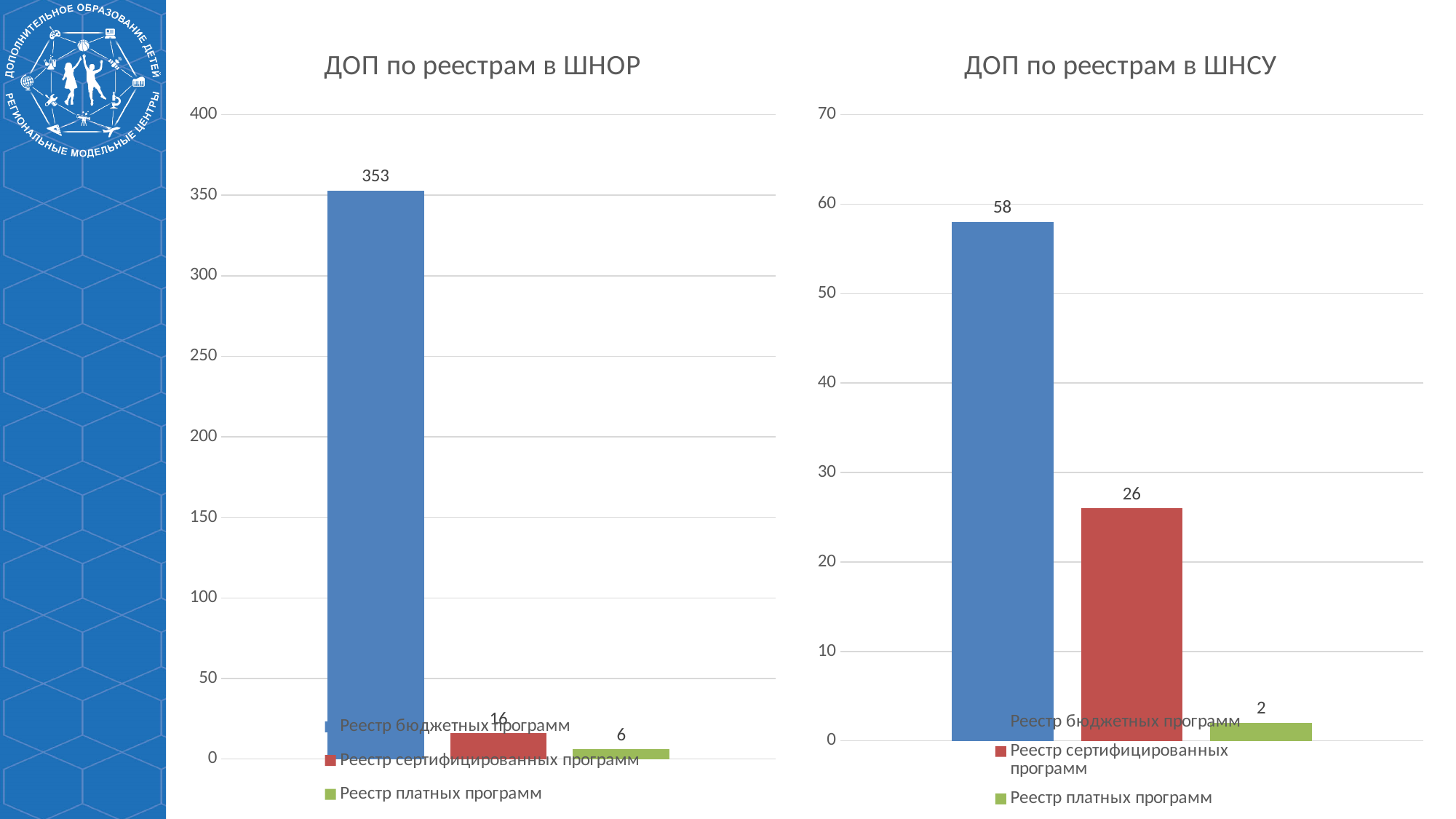
In the chart 'ДОП по реестрам в ШНОР', which series has the lowest value? Реестр платных программ In the chart 'ДОП по реестрам в ШНСУ', which series has the highest value? Реестр бюджетных программ In the chart 'ДОП по реестрам в ШНСУ', what is the value for Реестр платных программ? 2 In the chart 'ДОП по реестрам в ШНОР', what is the value for Реестр бюджетных программ? 353 In the chart 'ДОП по реестрам в ШНСУ', what is the difference between Реестр бюджетных программ and Реестр сертифицированных программ? 32 In the chart 'ДОП по реестрам в ШНОР', what colour is the bar for Реестр платных программ? Green In the chart 'ДОП по реестрам в ШНСУ', what is the value for Реестр сертифицированных программ? 26 What kind of chart is 'ДОП по реестрам в ШНОР'? Bar chart In the chart 'ДОП по реестрам в ШНОР', what is the value for Реестр сертифицированных программ? 16 How many series does the legend of the chart 'ДОП по реестрам в ШНСУ' list? 3 In the chart 'ДОП по реестрам в ШНОР', what is the difference between Реестр бюджетных программ and Реестр сертифицированных программ? 337 Which is larger: Реестр сертифицированных программ in 'ДОП по реестрам в ШНОР' or Реестр сертифицированных программ in 'ДОП по реестрам в ШНСУ'? ДОП по реестрам в ШНСУ